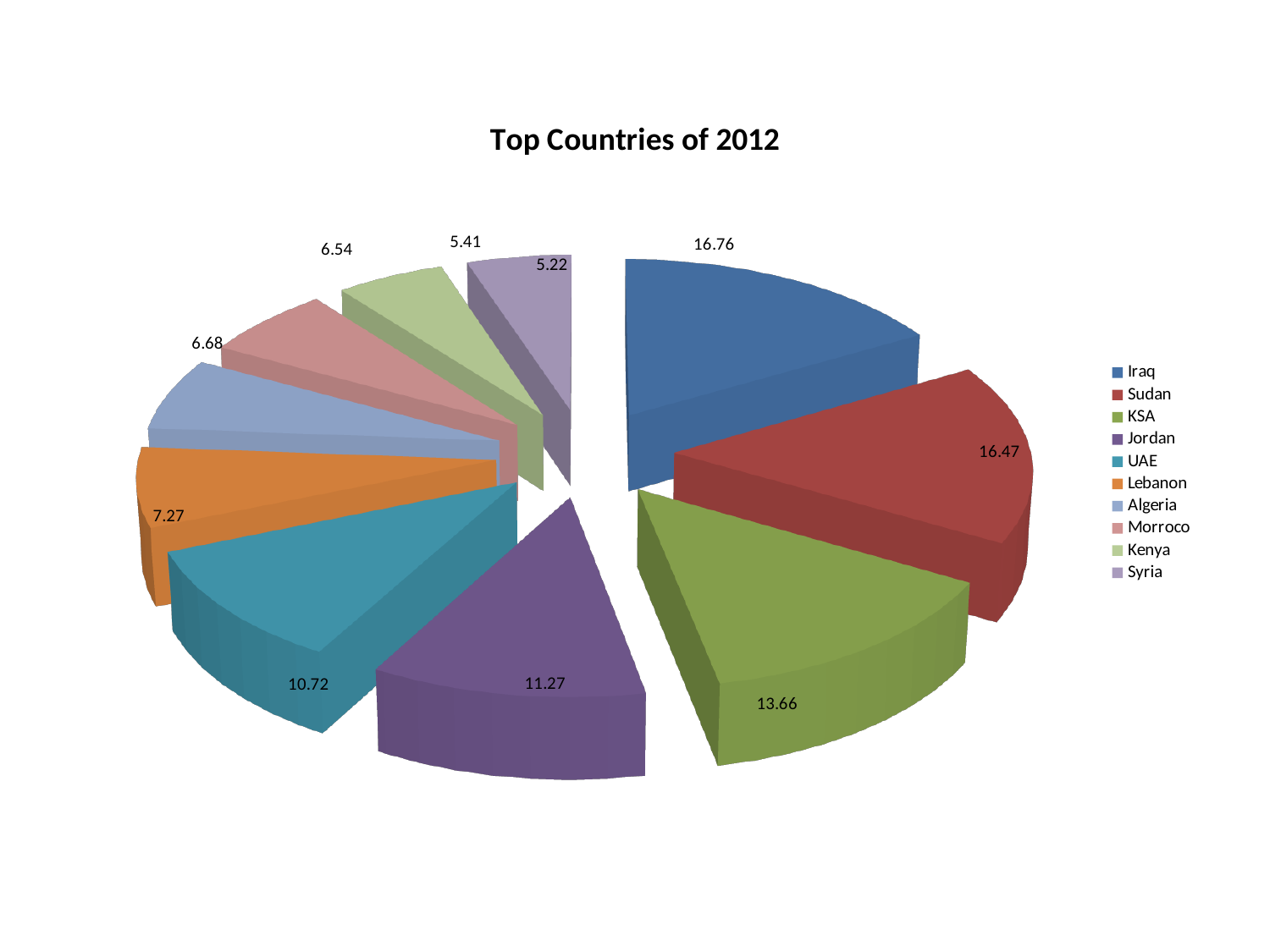
What is the title of the chart? Top Countries of 2012 What is the value for Kenya? 5.41 What is the value for Lebanon? 7.27 What is the difference between the values for KSA and Algeria? 6.98 How many countries are shown in the pie chart? 10 What type of chart is shown on the slide? Pie chart What is the difference between the values for Iraq and Sudan? 0.29 What is the value for Iraq? 16.76 Which country has the largest slice? Iraq Which country has the smallest slice? Syria What is the value for KSA? 13.66 Which is larger, the value for Jordan or the value for UAE? Jordan